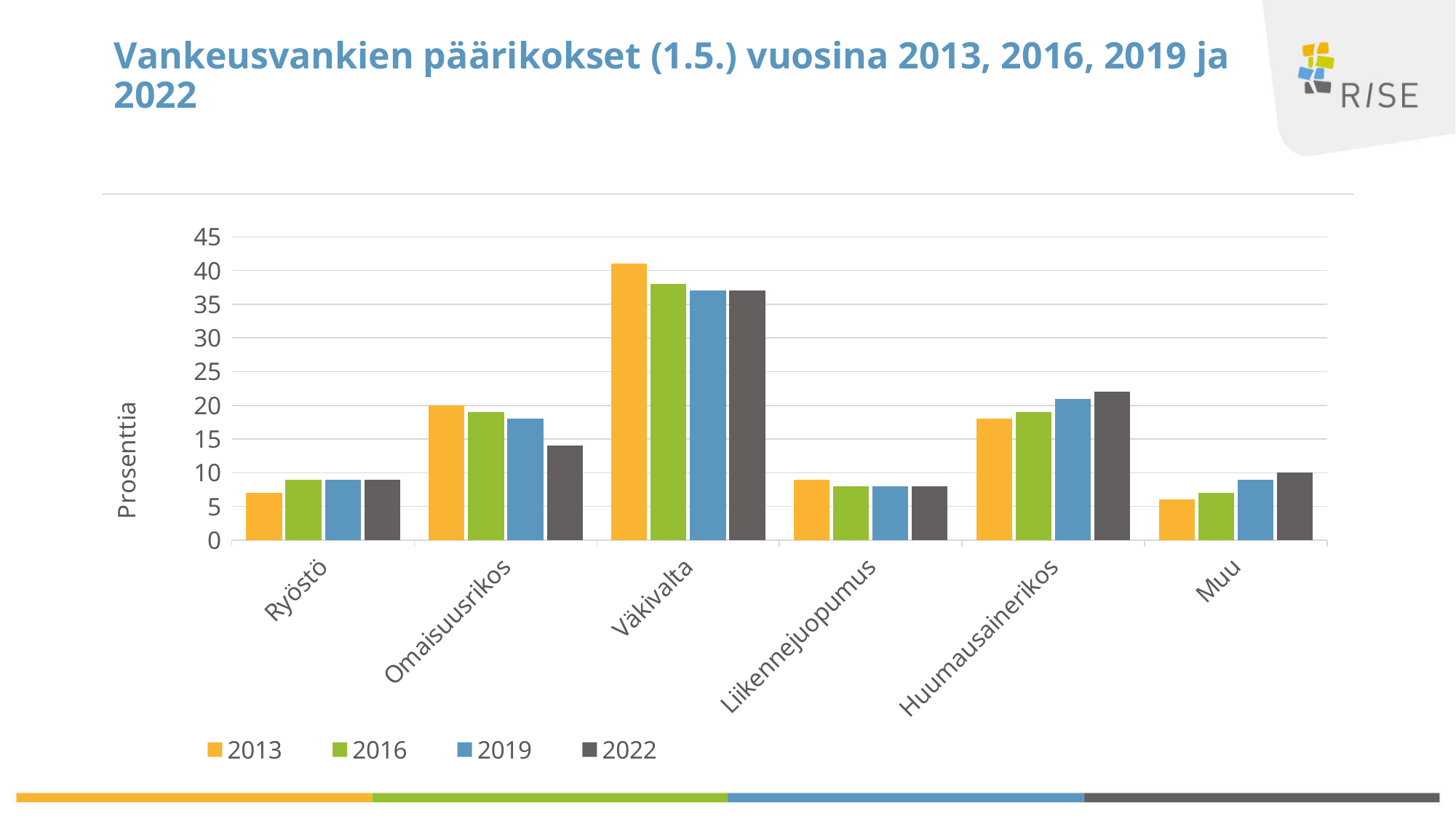
Is the value for Väkivalta in 2013 greater or less than 35? greater Is the value for Muu in 2013 greater or less than 10? less What kind of chart is shown on the slide? bar chart How many series does the legend list? 4 For Väkivalta, which year has the highest value? 2013 For Omaisuusrikos, which year has the lowest value? 2022 Which is larger in 2022: Huumausainerikos or Omaisuusrikos? Huumausainerikos Do the values for Huumausainerikos rise or fall from 2013 to 2022? rise Which category has the highest value for 2013? Väkivalta How many crime categories are shown on the x axis? 6 What is the label on the y axis? Prosenttia Is the value for Omaisuusrikos in 2013 greater or less than 15? greater